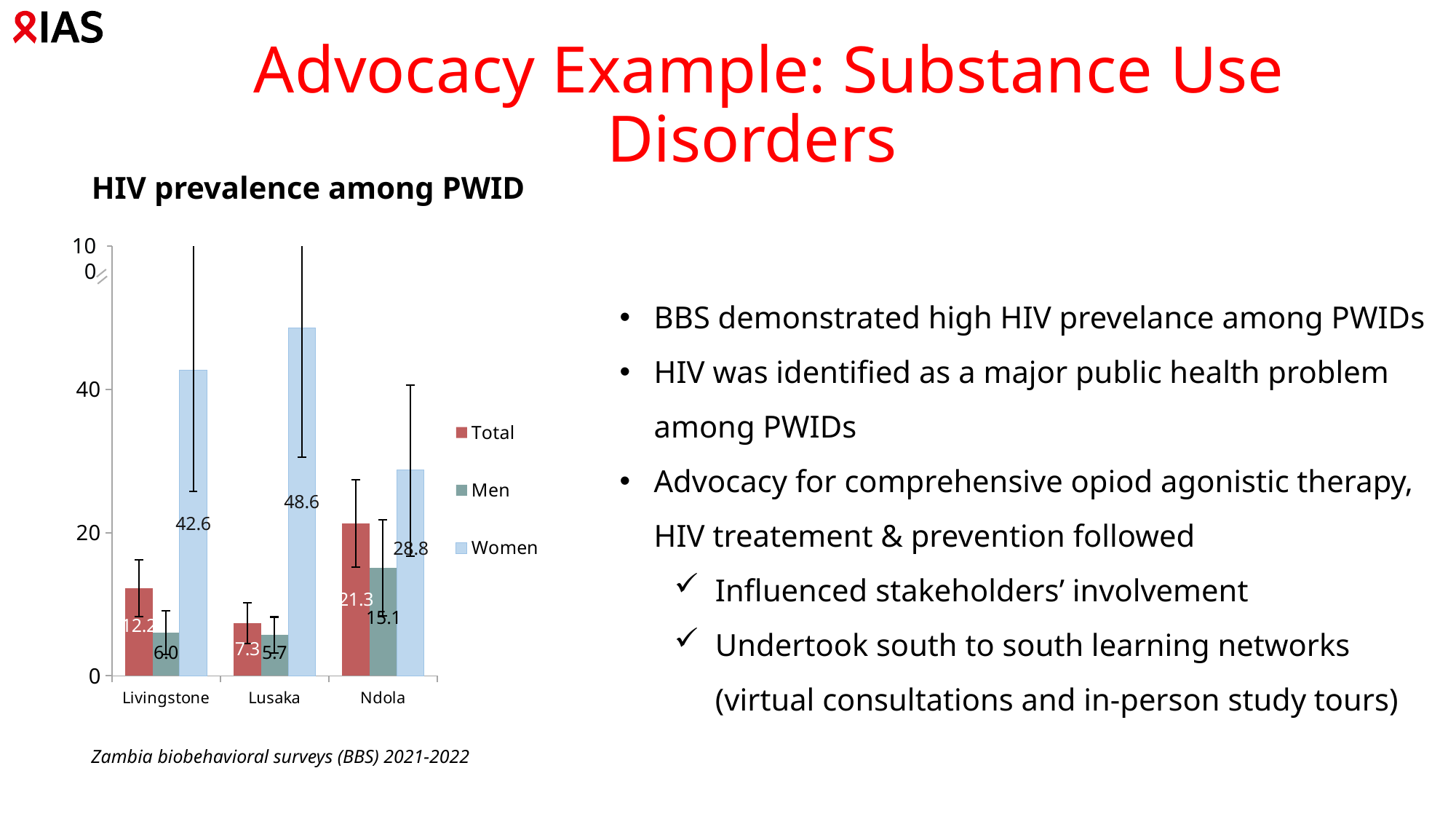
Is the Total value for Livingstone or for Ndola larger? Ndola Is the value for Women in Livingstone greater or less than 40? greater Which city has the lowest value for Men? Lusaka What is the value for Men in Livingstone? 6.0 What is the difference between the Women and Men values in Ndola? 13.7 What is the HIV prevalence among women in Lusaka? 48.6 How many series does the legend list? 3 What is the Total HIV prevalence value for Ndola? 21.3 What kind of chart is shown on the slide? Bar chart How many cities are shown on the x axis? 3 Which city has the highest HIV prevalence among women? Lusaka What is the title of the chart? HIV prevalence among PWID